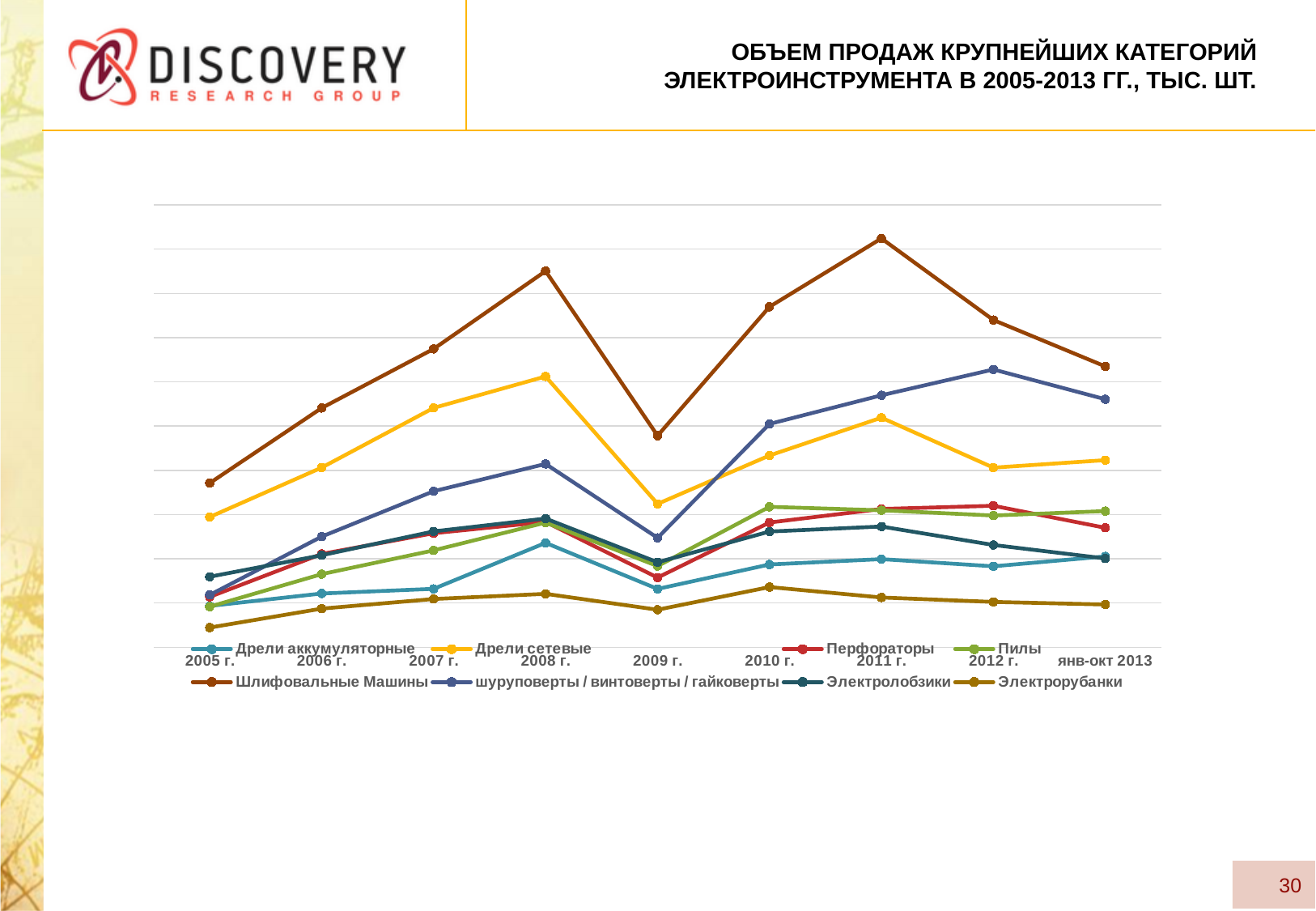
Which category had the highest sales volume in 2011? Шлифовальные Машины Did sales of Шлифовальные Машины rise or fall from 2011 to янв-окт 2013? fall In 2005, which was larger: Дрели сетевые or шуруповерты / винтоверты / гайковерты? Дрели сетевые What is the title of the chart on the slide? ОБЪЕМ ПРОДАЖ КРУПНЕЙШИХ КАТЕГОРИЙ ЭЛЕКТРОИНСТРУМЕНТА В 2005-2013 ГГ., ТЫС. ШТ. How many series does the legend list? 8 In which year did Дрели сетевые reach their peak sales volume? 2008 г. Did sales of Шлифовальные Машины rise or fall from 2005 to 2008? rise In 2012, which was larger: Дрели сетевые or шуруповерты / винтоверты / гайковерты? шуруповерты / винтоверты / гайковерты What kind of chart is shown on the slide? line chart Which category had the lowest sales volume in 2005? Электрорубанки In which year did Шлифовальные Машины reach their peak sales volume? 2011 г. How many time periods are shown along the x axis? 9